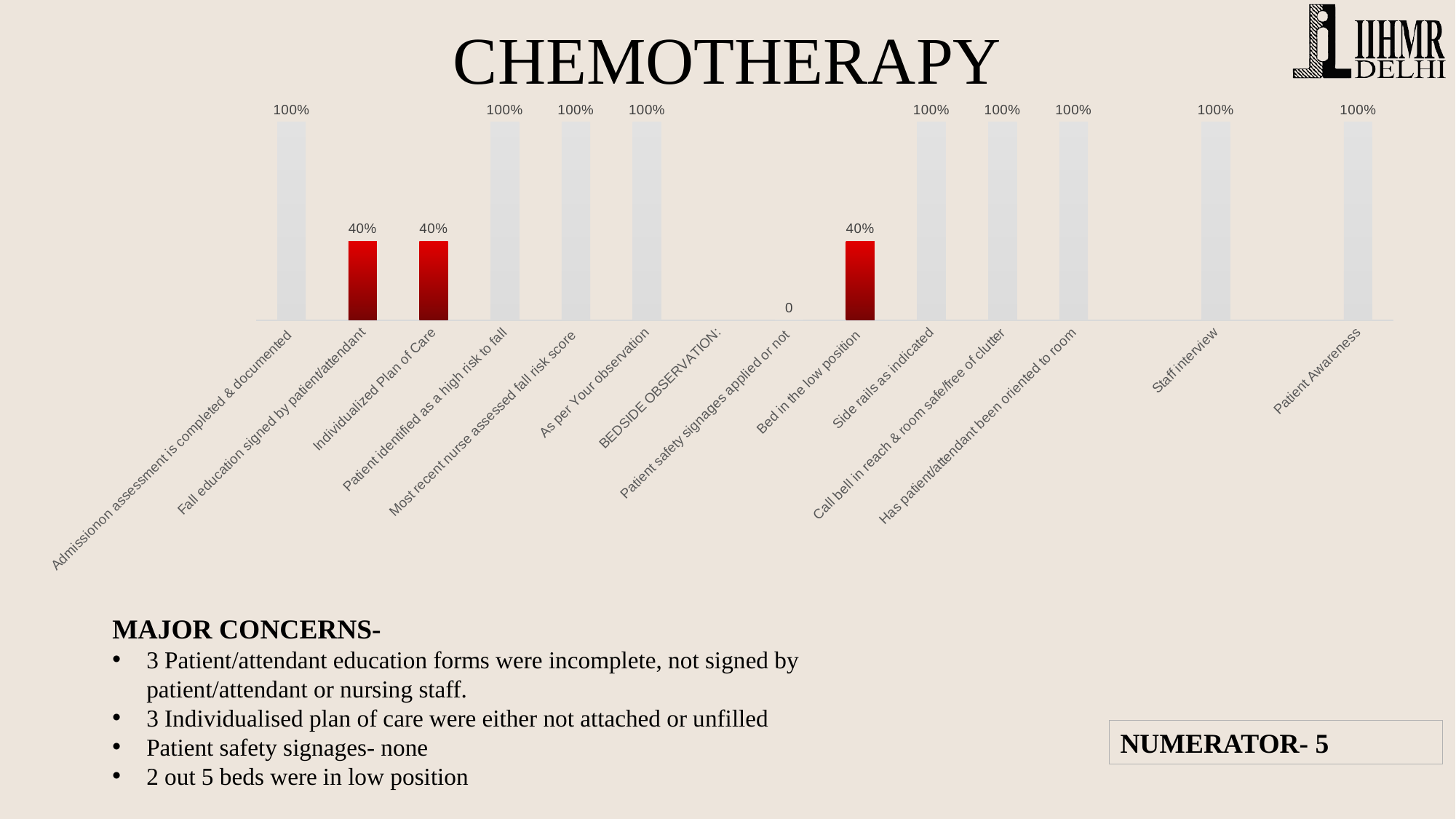
What kind of chart is shown on the slide? Bar chart What is the value for Side rails as indicated? 100% What is the value for Individualized Plan of Care? 40% Which is larger, the value for Patient Awareness or the value for Individualized Plan of Care? Patient Awareness What colour are the bars showing 40%? Red How many categories have a value of 100%? 9 Which category has the lowest value? Patient safety signages applied or not What is the difference between the value for Staff interview and the value for Bed in the low position? 60% How many categories have a value of 40%? 3 What is the value for Fall education signed by patient/attendant? 40% What is the value for Bed in the low position? 40% What is the value for Patient safety signages applied or not? 0